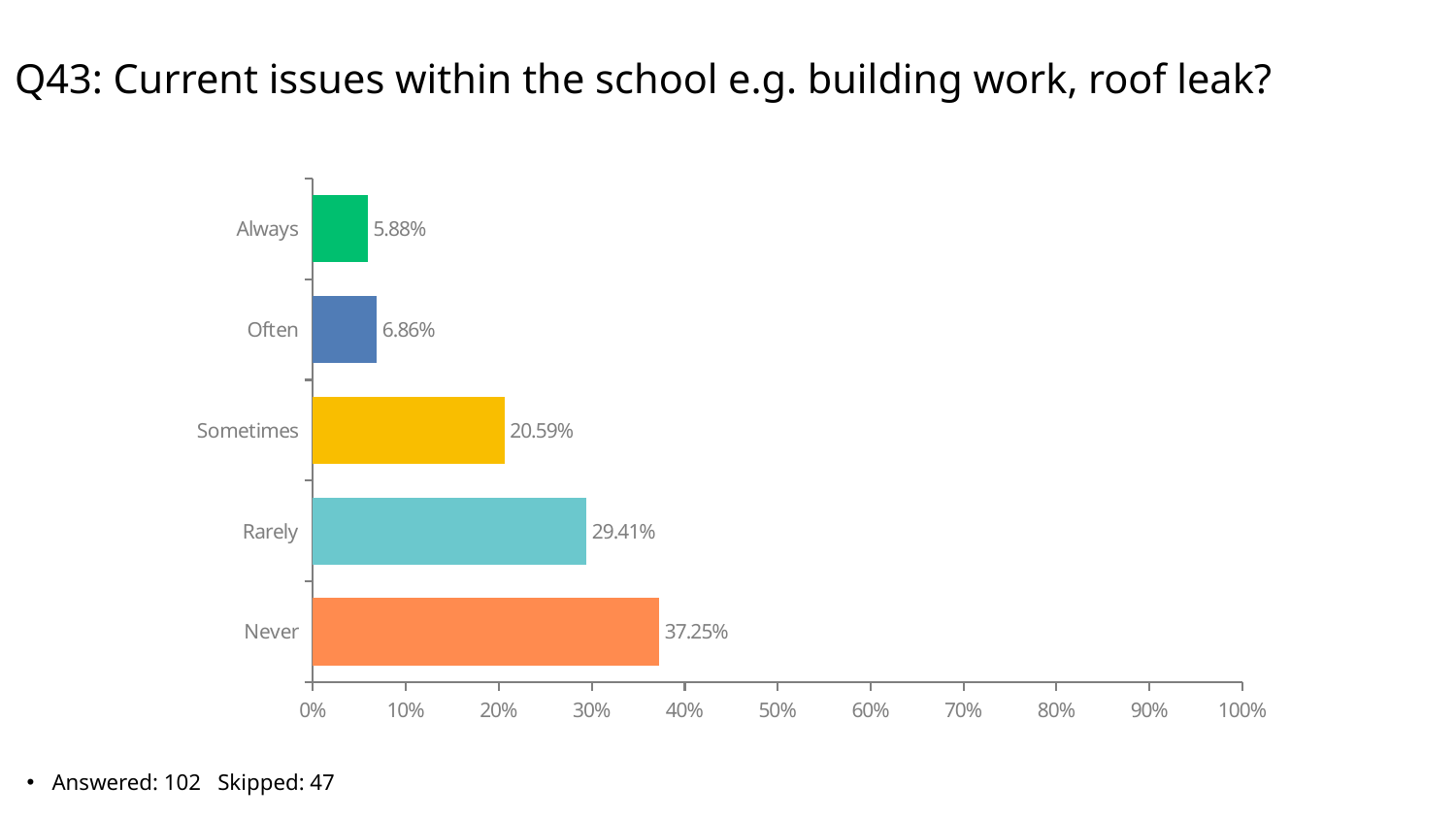
What is the difference between the values for Never and Rarely? 7.84% How many categories are shown in the chart? 5 Which is larger, the value for Sometimes or the value for Rarely? Rarely What is the value for Never? 37.25% What is the value for Sometimes? 20.59% What is the title of the chart? Q43: Current issues within the school e.g. building work, roof leak? What is the value for Often? 6.86% Which category has the lowest value? Always What colour is the bar for Sometimes? yellow Which category has the highest value? Never Is the value for Never greater or less than 40%? less What kind of chart is shown on the slide? bar chart